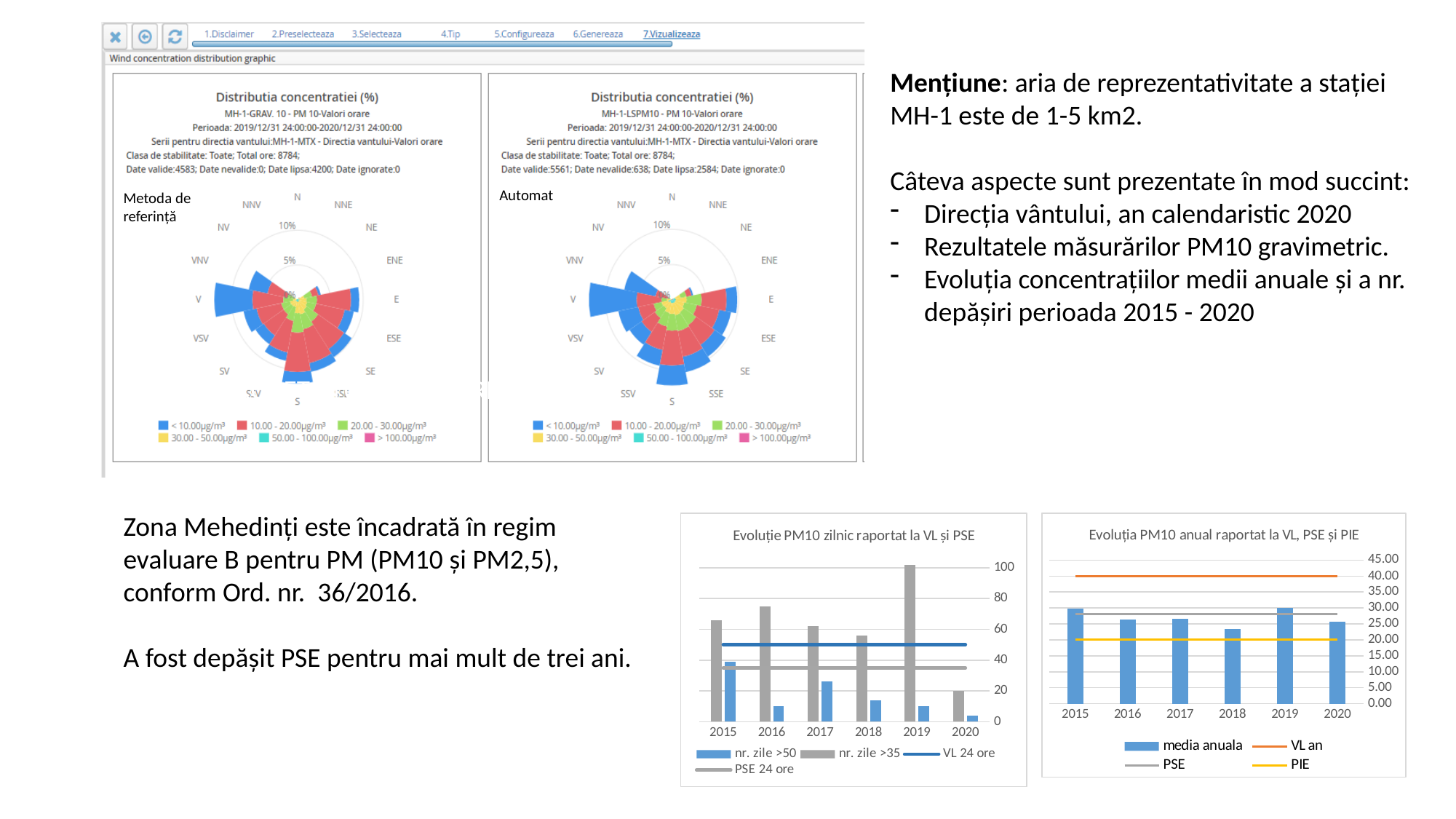
In the chart 'Evoluția PM10 anual raportat la VL, PSE și PIE', is the 'media anuala' value for 2018 greater or less than 25.00? less In the chart 'Evoluția PM10 anual raportat la VL, PSE și PIE', what colour is the 'VL an' line? orange What kind of chart is 'Evoluția PM10 anual raportat la VL, PSE și PIE'? combination bar and line chart In the chart 'Evoluție PM10 zilnic raportat la VL și PSE', is the value of 'nr. zile >50' for 2015 greater or less than 20? greater In the chart 'Evoluție PM10 zilnic raportat la VL și PSE', how many years are shown on the x axis? 6 What kind of chart is 'Evoluție PM10 zilnic raportat la VL și PSE'? combination bar and line chart How many series does the legend of 'Evoluție PM10 zilnic raportat la VL și PSE' list? 4 How many series does the legend of 'Evoluția PM10 anual raportat la VL, PSE și PIE' list? 4 In the chart 'Evoluție PM10 zilnic raportat la VL și PSE', which year has the lowest value for 'nr. zile >35'? 2020 In the chart 'Evoluție PM10 zilnic raportat la VL și PSE', which year has the highest value for 'nr. zile >35'? 2019 In the chart 'Evoluția PM10 anual raportat la VL, PSE și PIE', which is larger: the 'media anuala' for 2019 or for 2018? 2019 In the chart 'Evoluție PM10 zilnic raportat la VL și PSE', which is larger for 2016: 'nr. zile >50' or 'nr. zile >35'? nr. zile >35